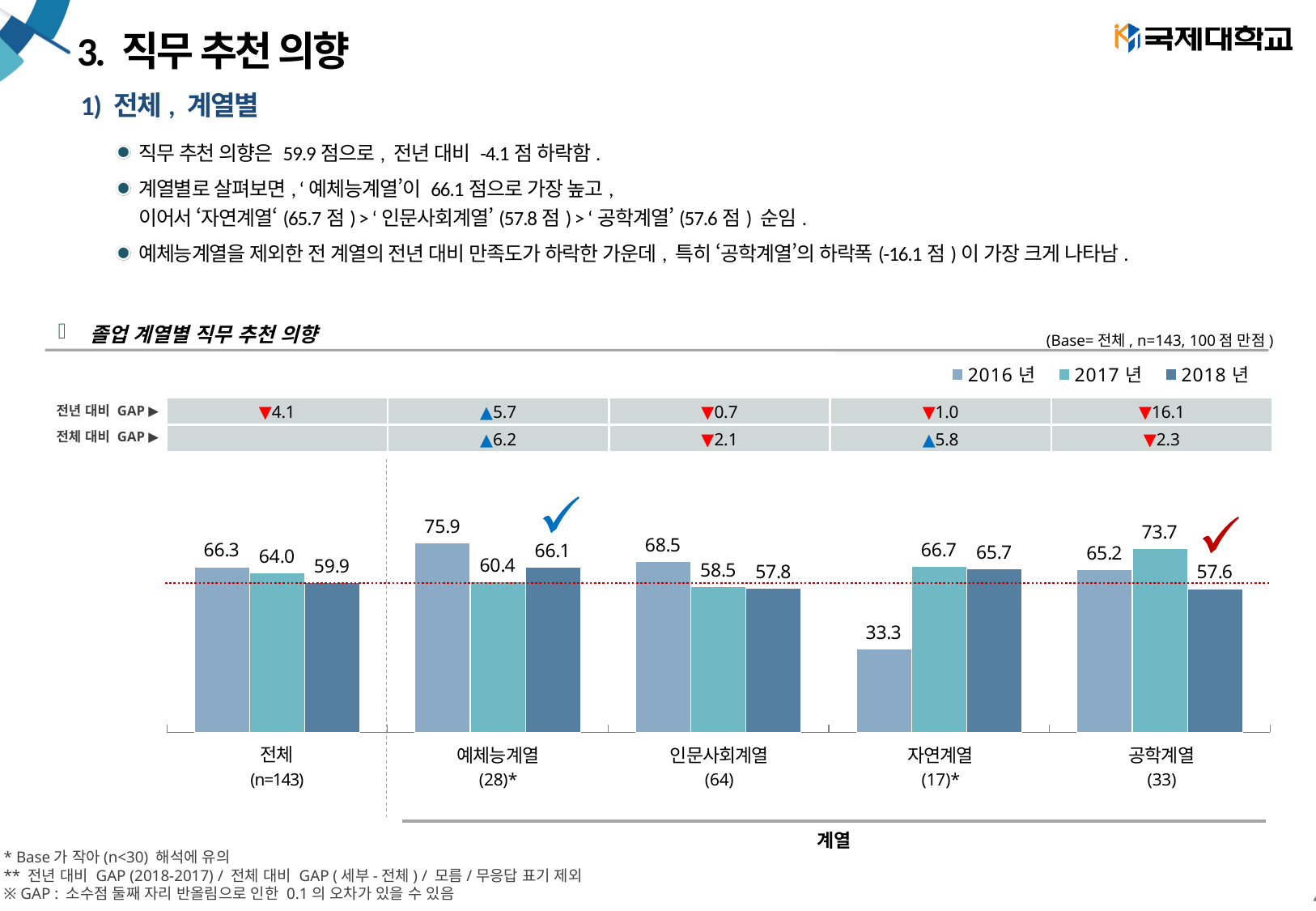
How many categories are shown along the x axis of the chart? 5 Which category has the highest 2018년 value? 예체능계열 Which category has the lowest 2016년 value? 자연계열 Which is larger for 인문사회계열: the 2016년 value or the 2017년 value? 2016년 Do the values for 전체 rise or fall from 2016년 to 2018년? fall What is the 2017년 value for 자연계열? 66.7 What is the difference between the 2017년 and 2018년 values for 공학계열? 16.1 What is the 2018년 value for 전체? 59.9 What is the 2016년 value for 예체능계열? 75.9 How many series does the chart legend list? 3 What is the 2017년 value for 공학계열? 73.7 What type of chart is shown on the slide? bar chart